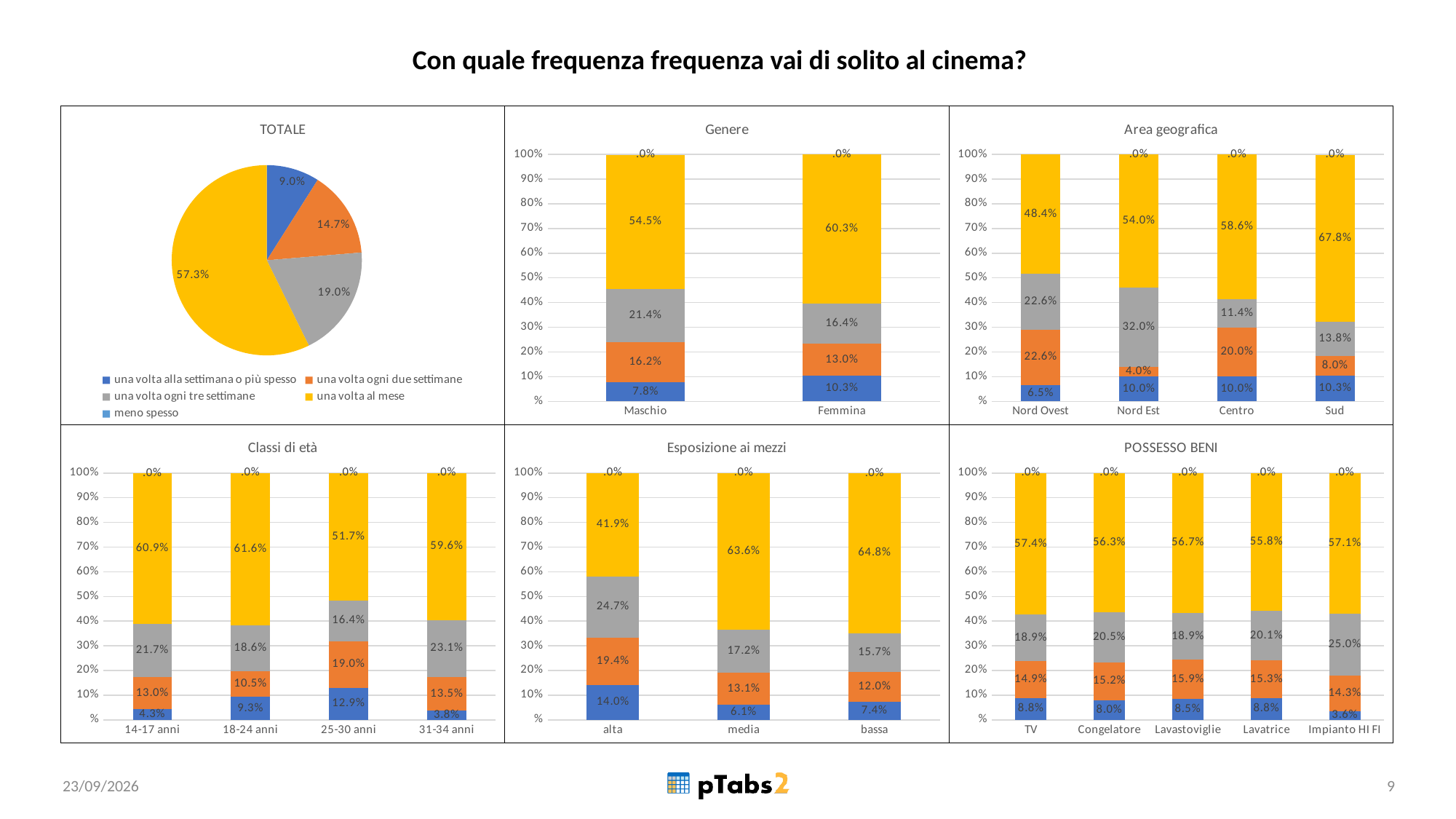
In the Area geografica chart, what is the value of 'una volta ogni due settimane' for Centro? 20.0% In the Genere chart, which has the larger value for 'una volta ogni due settimane', Maschio or Femmina? Maschio What kind of chart is the TOTALE chart? pie chart In the TOTALE pie chart, what share of respondents go to the cinema 'una volta al mese'? 57.3% How many age categories are shown on the x axis of the Classi di età chart? 4 In the Area geografica chart, what is the value of 'una volta ogni tre settimane' for Nord Est? 32.0% In the Esposizione ai mezzi chart, what is the difference between the 'una volta al mese' values for bassa and alta? 22.9 percentage points In the POSSESSO BENI chart, which category has the lowest value for 'una volta alla settimana o più spesso'? Impianto HI FI In the Classi di età chart, what is the value of 'una volta alla settimana o più spesso' for 25-30 anni? 12.9% In the Genere chart, what is the value of 'una volta al mese' for Femmina? 60.3% In the Area geografica chart, which region has the highest value for 'una volta al mese'? Sud How many entries does the legend of the TOTALE chart list? 5